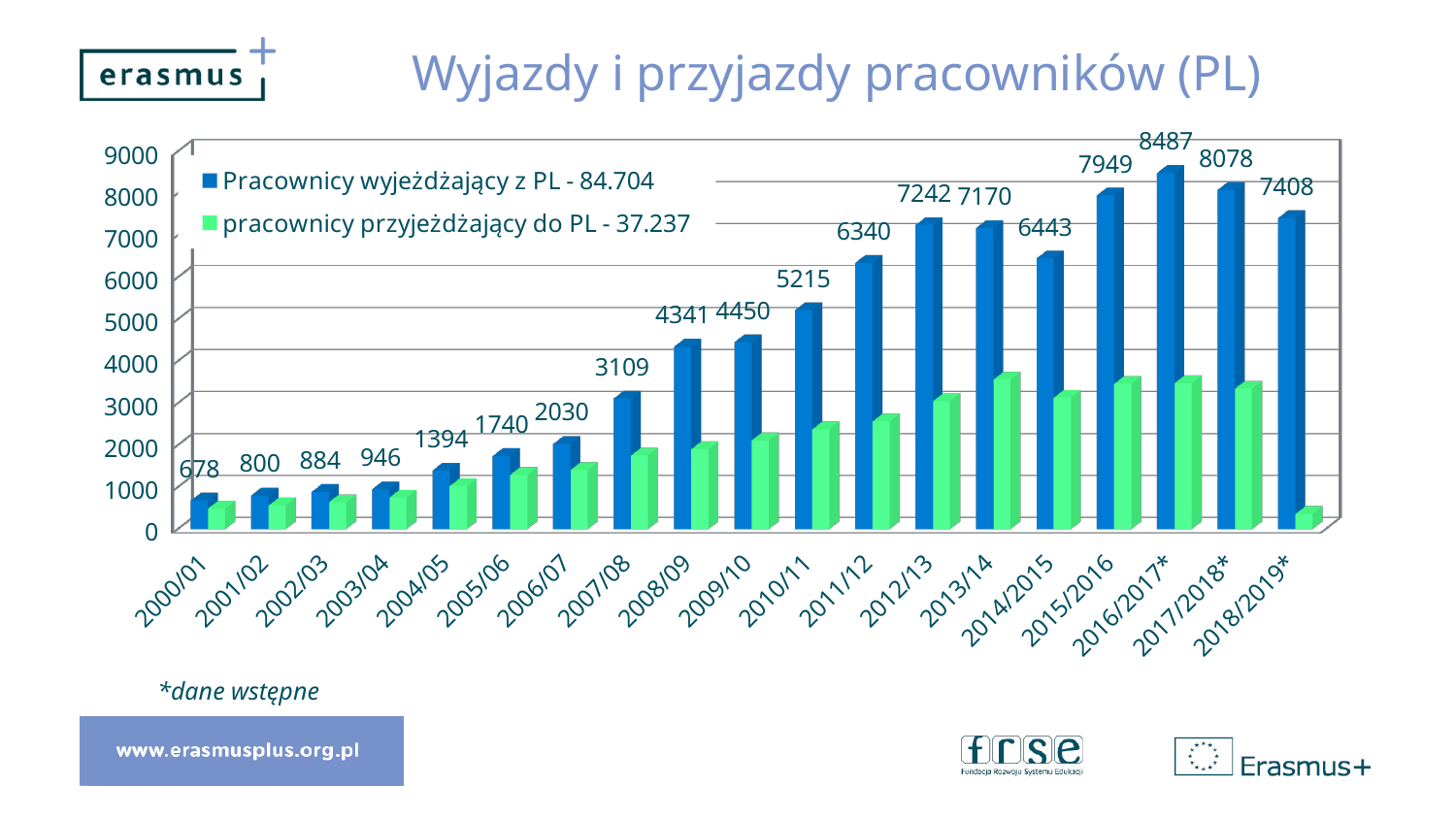
How many series does the legend list? 2 What is the difference between the 'Pracownicy wyjeżdżający z PL' values for 2012/13 and 2013/14? 72 In which year does the 'Pracownicy wyjeżdżający z PL' series reach its highest value? 2016/2017* Is the value for 'pracownicy przyjeżdżający do PL' in 2013/14 greater or less than 3000? greater How many academic years are shown on the x axis? 19 Which is larger for 'Pracownicy wyjeżdżający z PL': 2014/2015 or 2015/2016? 2015/2016 What is the value for 'Pracownicy wyjeżdżający z PL' in 2016/2017*? 8487 What kind of chart is shown on the slide? bar chart In which year does the 'Pracownicy wyjeżdżający z PL' series have its lowest value? 2000/01 What is the value for 'Pracownicy wyjeżdżający z PL' in 2000/01? 678 Is the value for 'pracownicy przyjeżdżający do PL' in 2018/2019* greater or less than 1000? less What is the value for 'Pracownicy wyjeżdżający z PL' in 2010/11? 5215